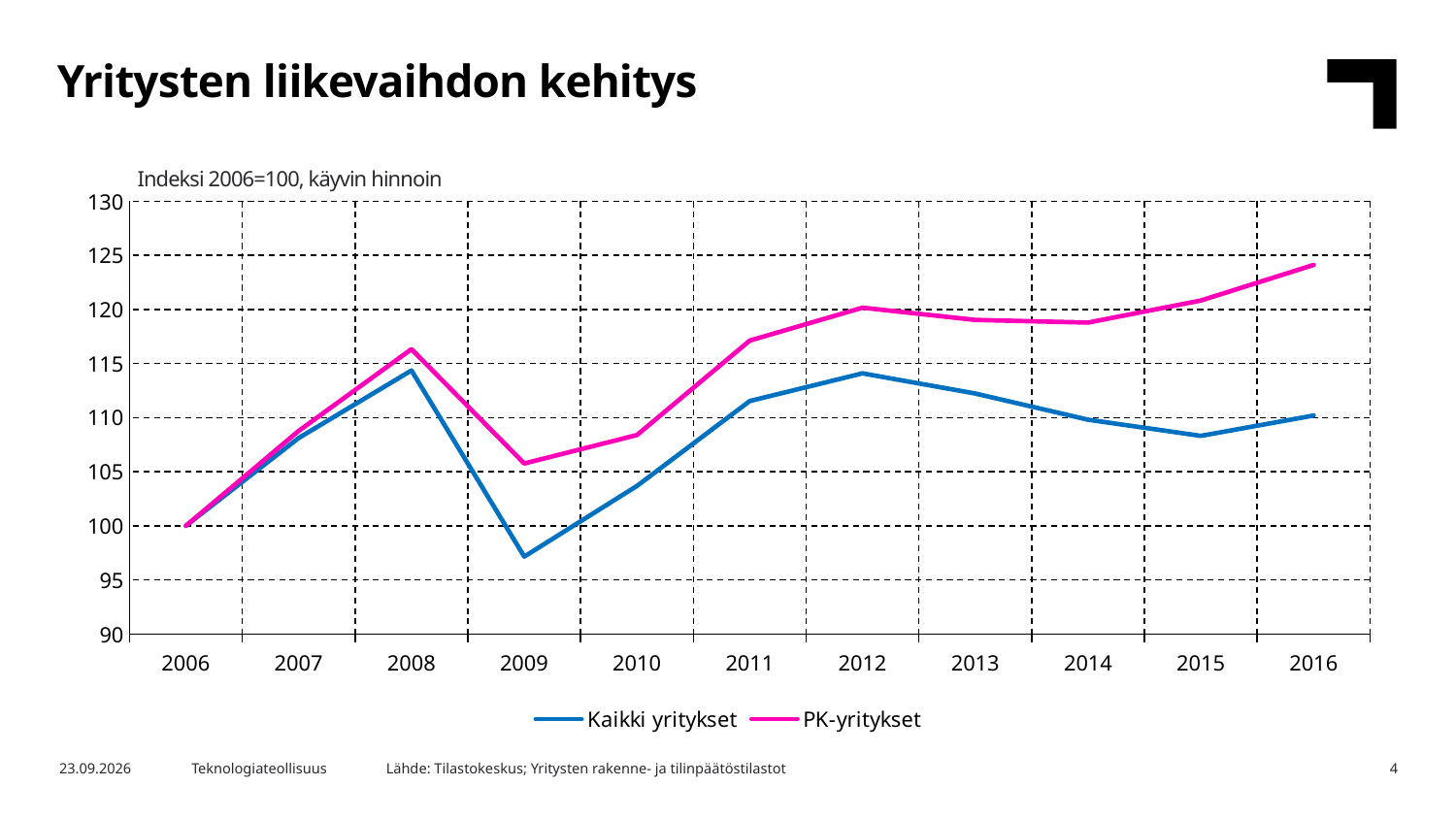
Is the value for Kaikki yritykset in 2009 greater or less than 100? less What is the subtitle shown above the chart? Indeksi 2006=100, käyvin hinnoin How many years are shown on the x axis? 11 What is the value for Kaikki yritykset in 2006? 100 Is the value for PK-yritykset in 2016 greater or less than 120? greater Is the value for Kaikki yritykset in 2012 greater or less than 110? greater Which series has the higher value in 2016, Kaikki yritykset or PK-yritykset? PK-yritykset How many series does the legend list? 2 Does the Kaikki yritykset line rise or fall from 2012 to 2015? Fall In which year is PK-yritykset at its highest? 2016 What kind of chart is shown on the slide? Line chart In which year is Kaikki yritykset at its lowest? 2009